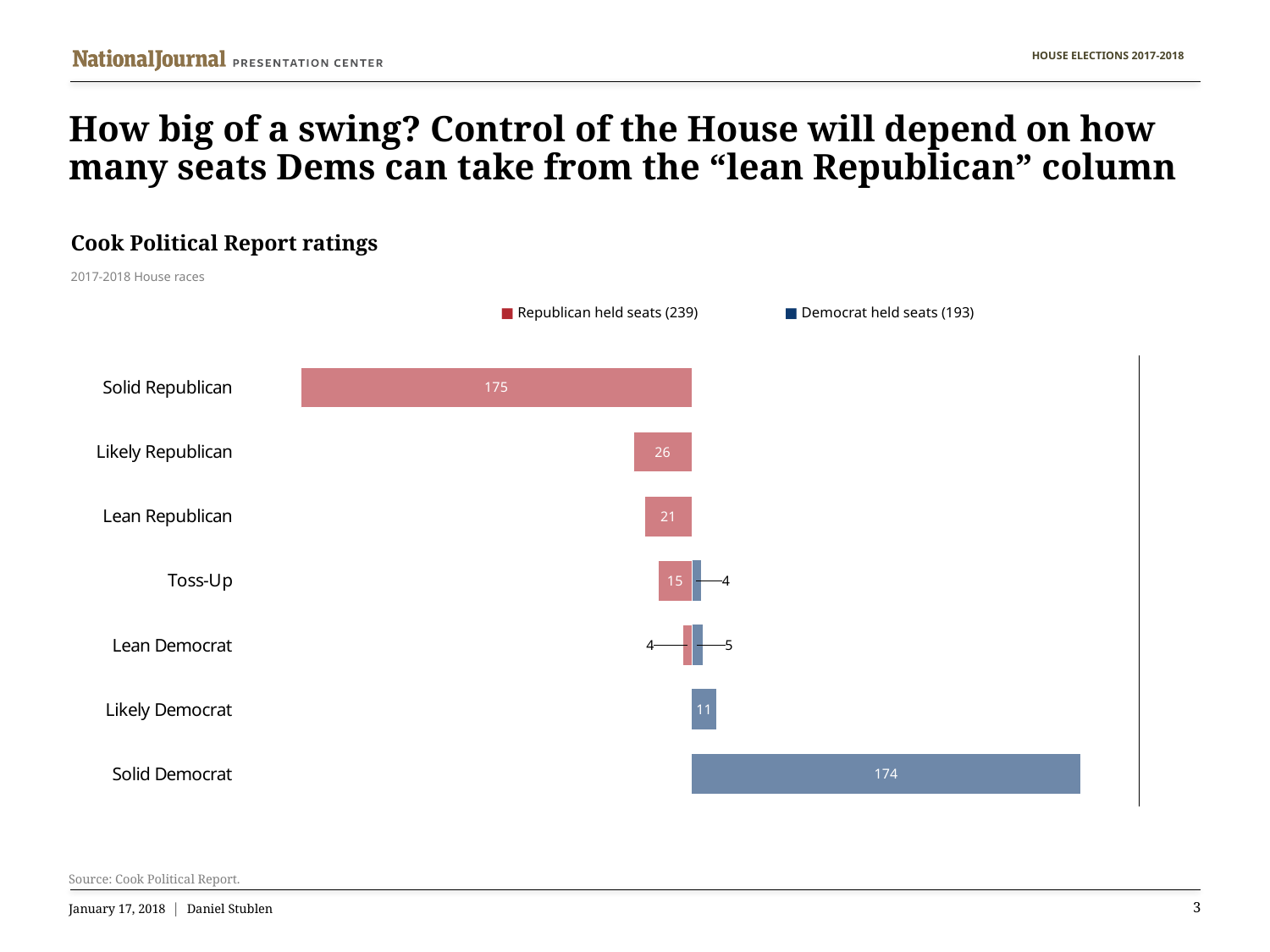
How many rating categories are shown on the chart? 7 How many Republican held seats are rated Lean Republican? 21 How many Republican held seats are rated Solid Republican? 175 What is the difference between the Republican held seats rated Likely Republican and those rated Lean Republican? 5 How many series does the legend list? 2 Which rating category has the most Republican held seats? Solid Republican How many Democrat held seats are in the Toss-Up category? 4 What is the total number of seats in the Toss-Up category across both series? 19 How many Democrat held seats are rated Solid Democrat? 174 Which is larger: the Republican held seats rated Solid Republican or the Democrat held seats rated Solid Democrat? Solid Republican What kind of chart is shown on the slide? Bar chart